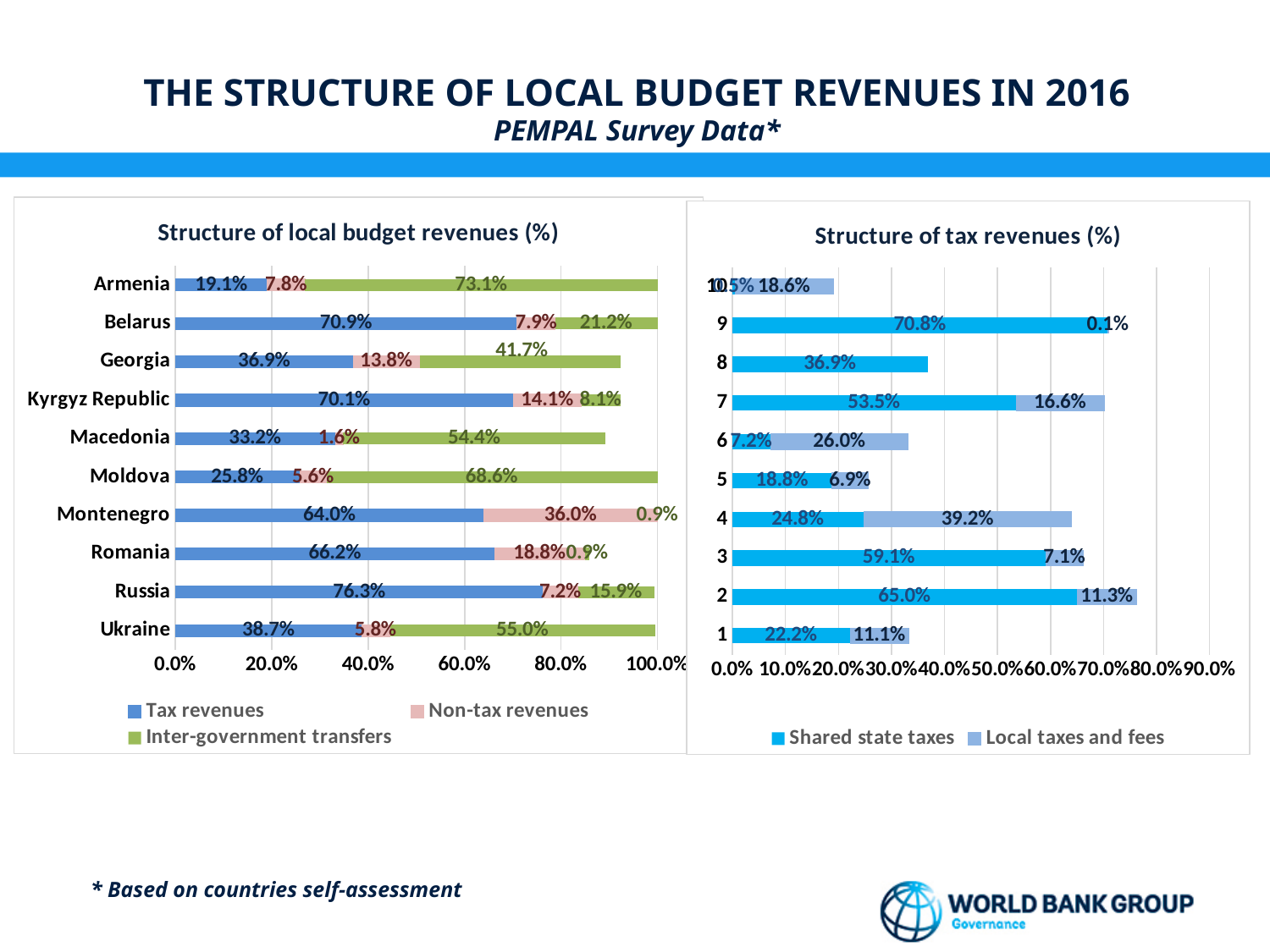
In the 'Structure of tax revenues (%)' chart, what is the Shared state taxes value for category 2? 65.0% In the 'Structure of tax revenues (%)' chart, which category has the highest Local taxes and fees value? 4 In the 'Structure of local budget revenues (%)' chart, what is the difference between the Tax revenues values for Russia and Armenia? 57.2 percentage points What type of chart is the 'Structure of tax revenues (%)' chart? Stacked bar chart How many series does the legend of the 'Structure of local budget revenues (%)' chart list? 3 How many countries are shown in the 'Structure of local budget revenues (%)' chart? 10 In the 'Structure of local budget revenues (%)' chart, which is larger: the Non-tax revenues value for Montenegro or for Romania? Montenegro In the 'Structure of local budget revenues (%)' chart, what is the Inter-government transfers value for Armenia? 73.1% In the 'Structure of tax revenues (%)' chart, what is the total of the stacked bar for category 7? 70.1% In the 'Structure of local budget revenues (%)' chart, which country has the highest Tax revenues share? Russia In the 'Structure of local budget revenues (%)' chart, what is the Tax revenues value for Belarus? 70.9% In the 'Structure of local budget revenues (%)' chart, which country has the lowest Tax revenues share? Armenia